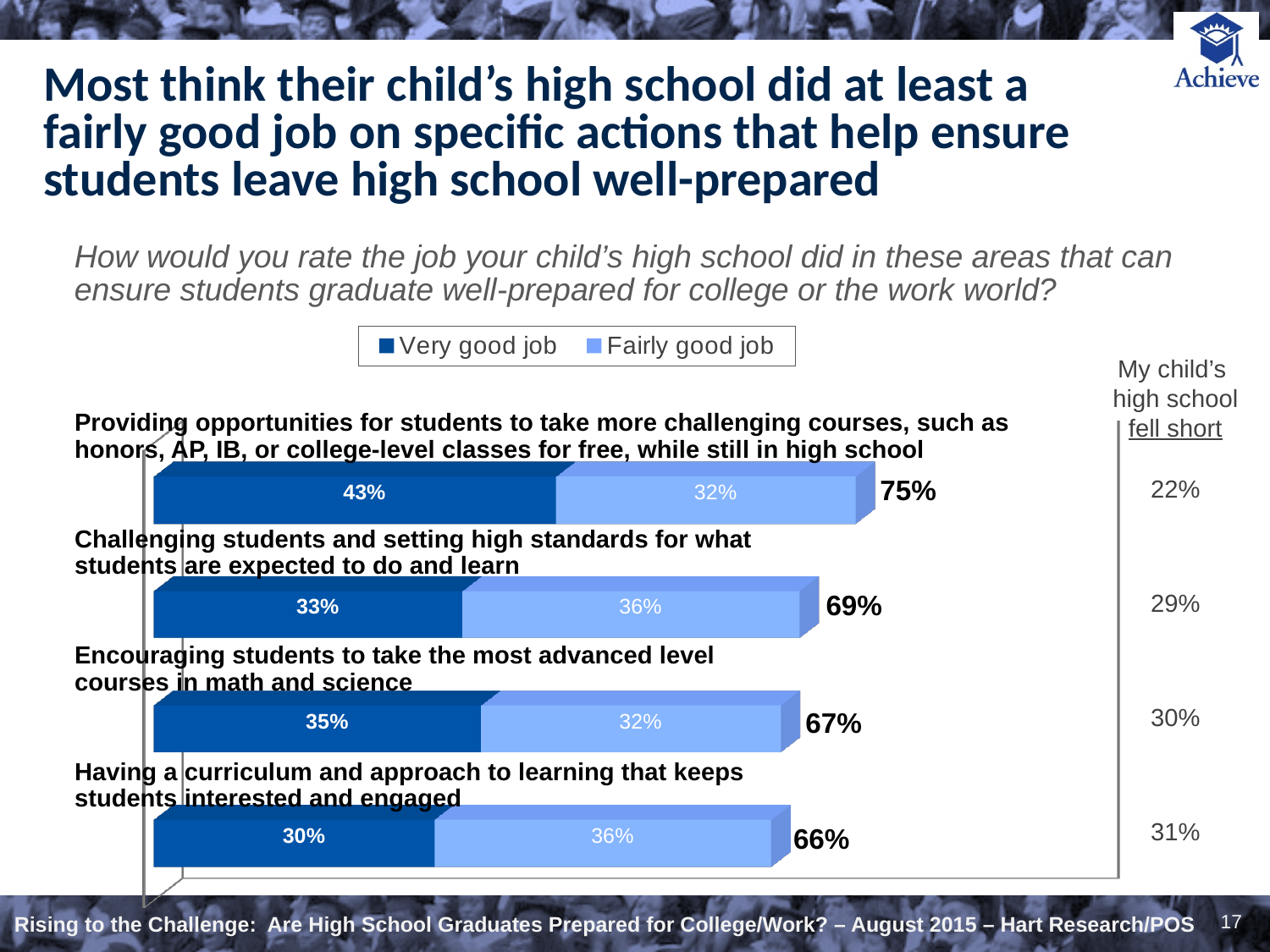
What percentage said the high school did a fairly good job challenging students and setting high standards for what students are expected to do and learn? 36% Which is larger: the 'Very good job' share for challenging students and setting high standards, or the 'Very good job' share for encouraging students to take the most advanced level courses in math and science? Encouraging students to take the most advanced level courses in math and science (35%) What is the difference between the 'Very good job' percentages for providing opportunities to take more challenging courses (43%) and having a curriculum that keeps students interested and engaged (30%)? 13 percentage points What kind of chart is shown on the slide? Stacked bar chart Which area has the lowest 'Very good job' percentage? Having a curriculum and approach to learning that keeps students interested and engaged What percentage said their child's high school fell short on having a curriculum and approach to learning that keeps students interested and engaged? 31% Which area has the highest combined very good/fairly good job total? Providing opportunities for students to take more challenging courses, such as honors, AP, IB, or college-level classes for free, while still in high school What is the combined total (very good plus fairly good job) for encouraging students to take the most advanced level courses in math and science? 67% How many series does the legend list? 2 What percentage said the high school did a very good job providing opportunities for students to take more challenging courses, such as honors, AP, IB, or college-level classes for free? 43% Which series is shown in the darker blue colour in the chart? Very good job How many categories (areas) are plotted in the chart? 4